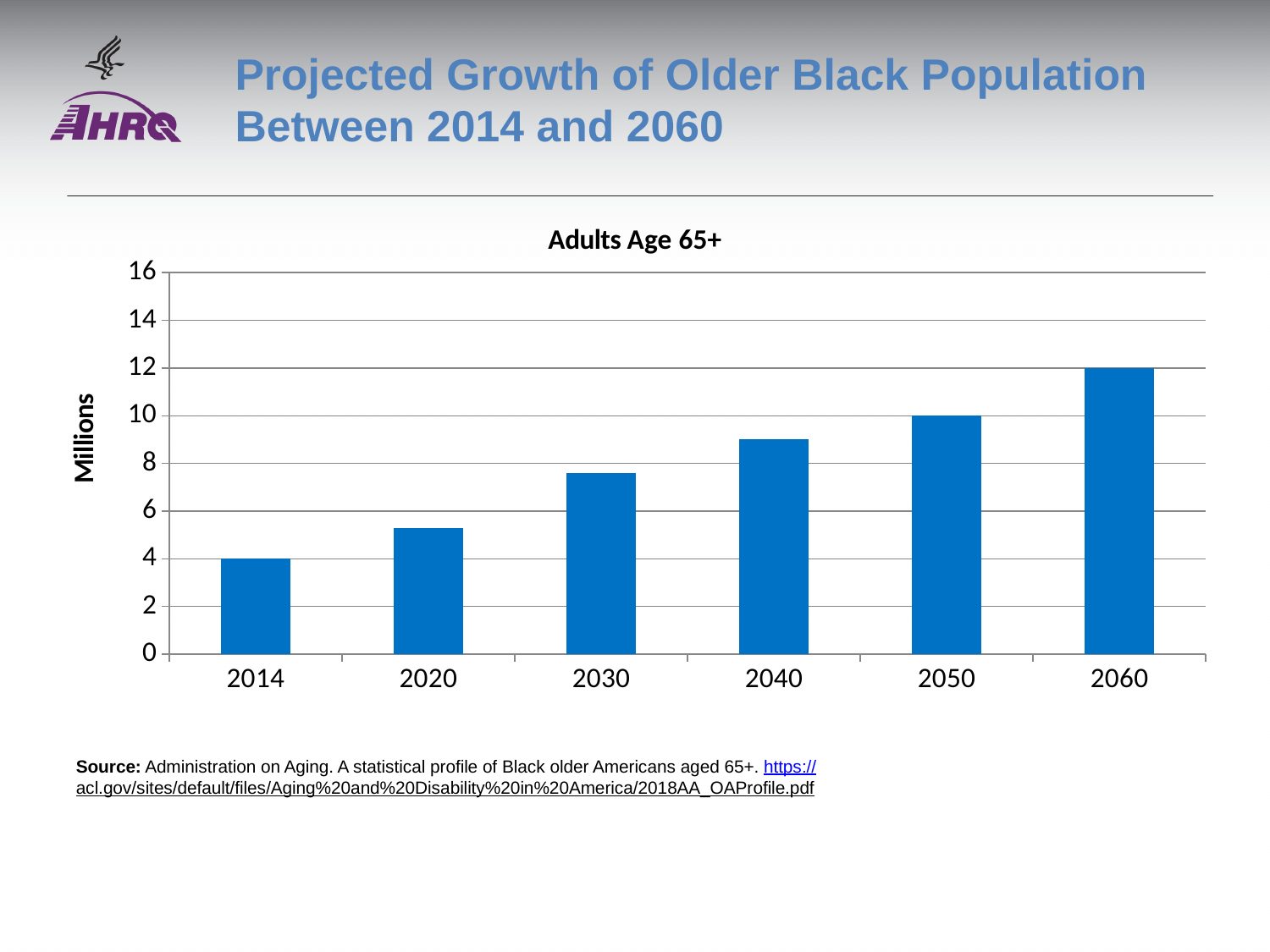
Which year has the highest value? 2060 Do the values rise or fall from 2014 to 2060? rise By how many millions does the value for 2060 exceed the value for 2014? 8 Which year has the lowest value? 2014 Is the value for 2030 greater or less than 8? less What is the value for 2014, in millions? 4 What is the value for 2060, in millions? 12 What is the value for 2050, in millions? 10 What is the label on the vertical axis? Millions How many years are shown on the x axis? 6 What is the chart's title? Adults Age 65+ What type of chart is shown on the slide? bar chart